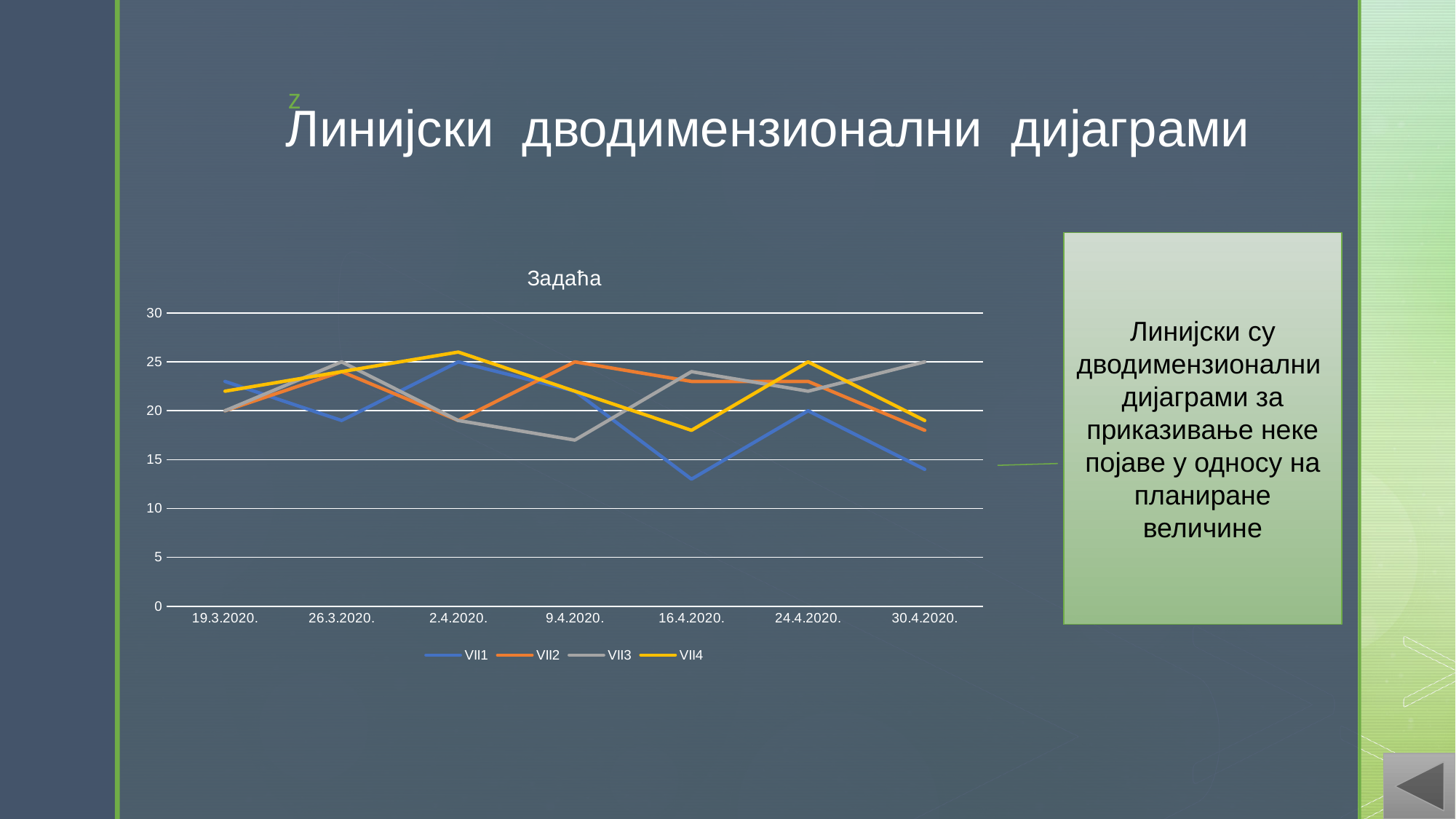
Does the VII1 line rise or fall from 2.4.2020. to 16.4.2020.? fall What is the title of the chart? Задаћа Which series has the highest value on 30.4.2020.? VII3 How many dates are shown on the x axis of the chart? 7 Is the value for VII1 on 16.4.2020. greater or less than 15? less Is the value for VII4 on 16.4.2020. greater or less than 20? less How many series does the chart legend list? 4 Which series has the lowest value on 16.4.2020.? VII1 Is the value for VII3 on 16.4.2020. greater or less than 20? greater What kind of chart is shown on the slide? line chart Which series are listed in the chart legend? VII1, VII2, VII3, VII4